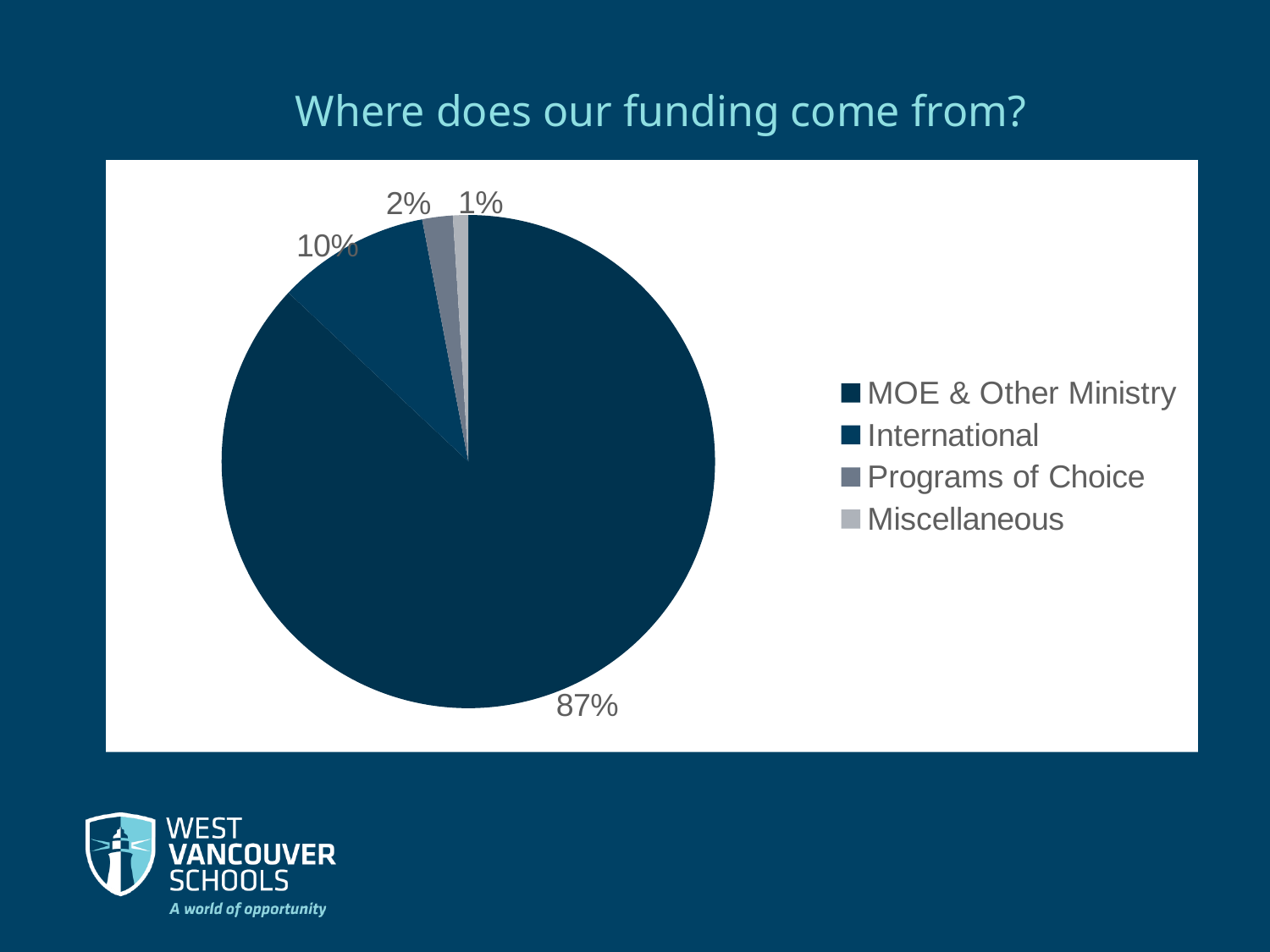
Which is larger, the International share or the Programs of Choice share? International How many funding sources are shown in the pie chart? 4 What share of funding comes from MOE & Other Ministry? 87% What share of funding comes from Programs of Choice? 2% What share of funding comes from Miscellaneous? 1% Which legend entry is listed third? Programs of Choice Which funding source has the largest share? MOE & Other Ministry Which funding source has the smallest share? Miscellaneous What is the title of the slide? Where does our funding come from? What kind of chart is shown on the slide? Pie chart What is the difference in percentage points between the MOE & Other Ministry share and the International share? 77